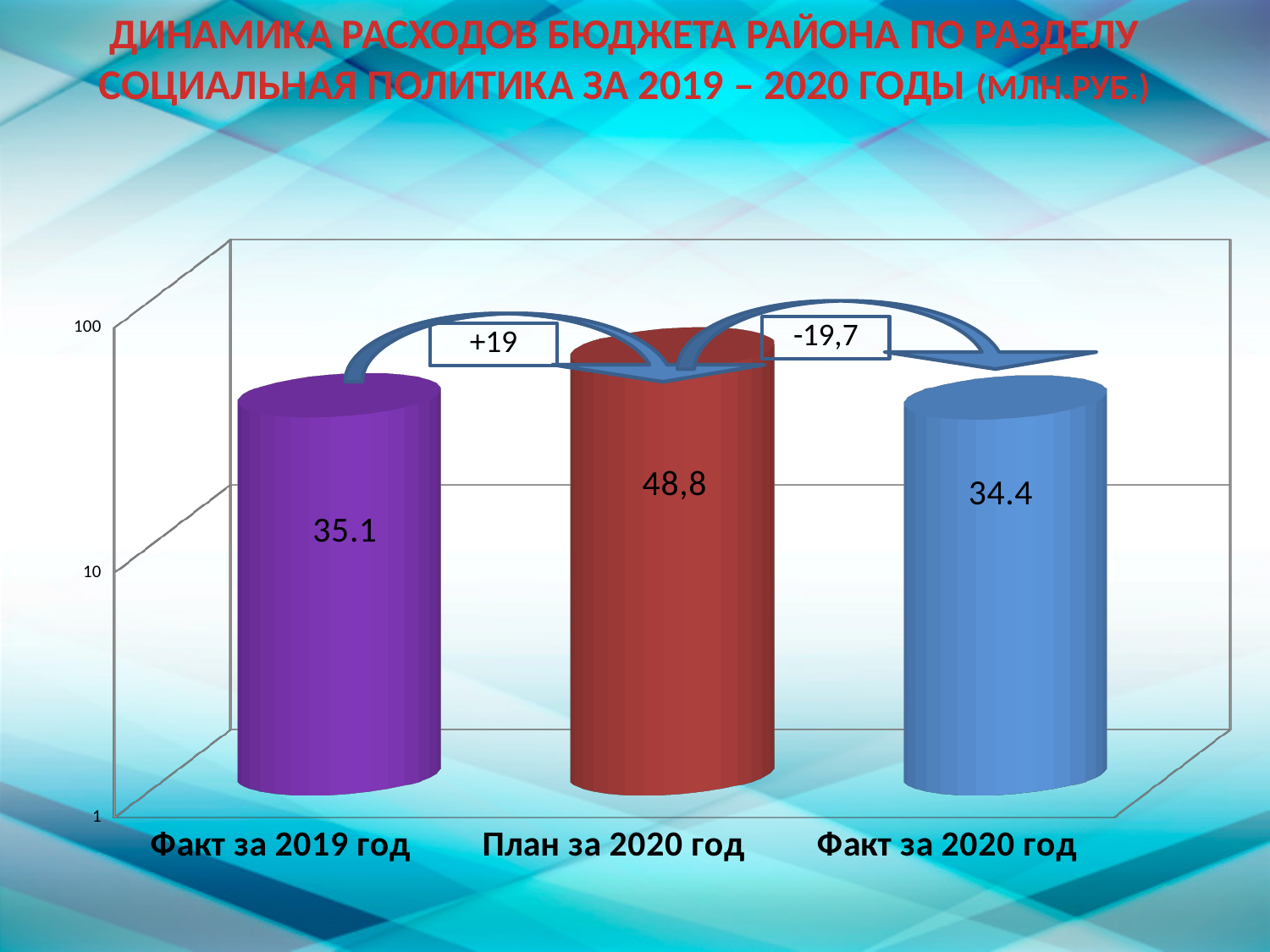
How many categories are shown on the chart? 3 What is the value for План за 2020 год? 48,8 What is the value for Факт за 2020 год? 34.4 Which is larger, the value for Факт за 2019 год or the value for Факт за 2020 год? Факт за 2019 год What is the value for Факт за 2019 год? 35.1 Which category has the highest value? План за 2020 год What kind of chart is shown on the slide? bar chart What change is written in the label on the arrow between План за 2020 год and Факт за 2020 год? -19,7 Which category has the lowest value? Факт за 2020 год Is the value for План за 2020 год greater or less than 100? less